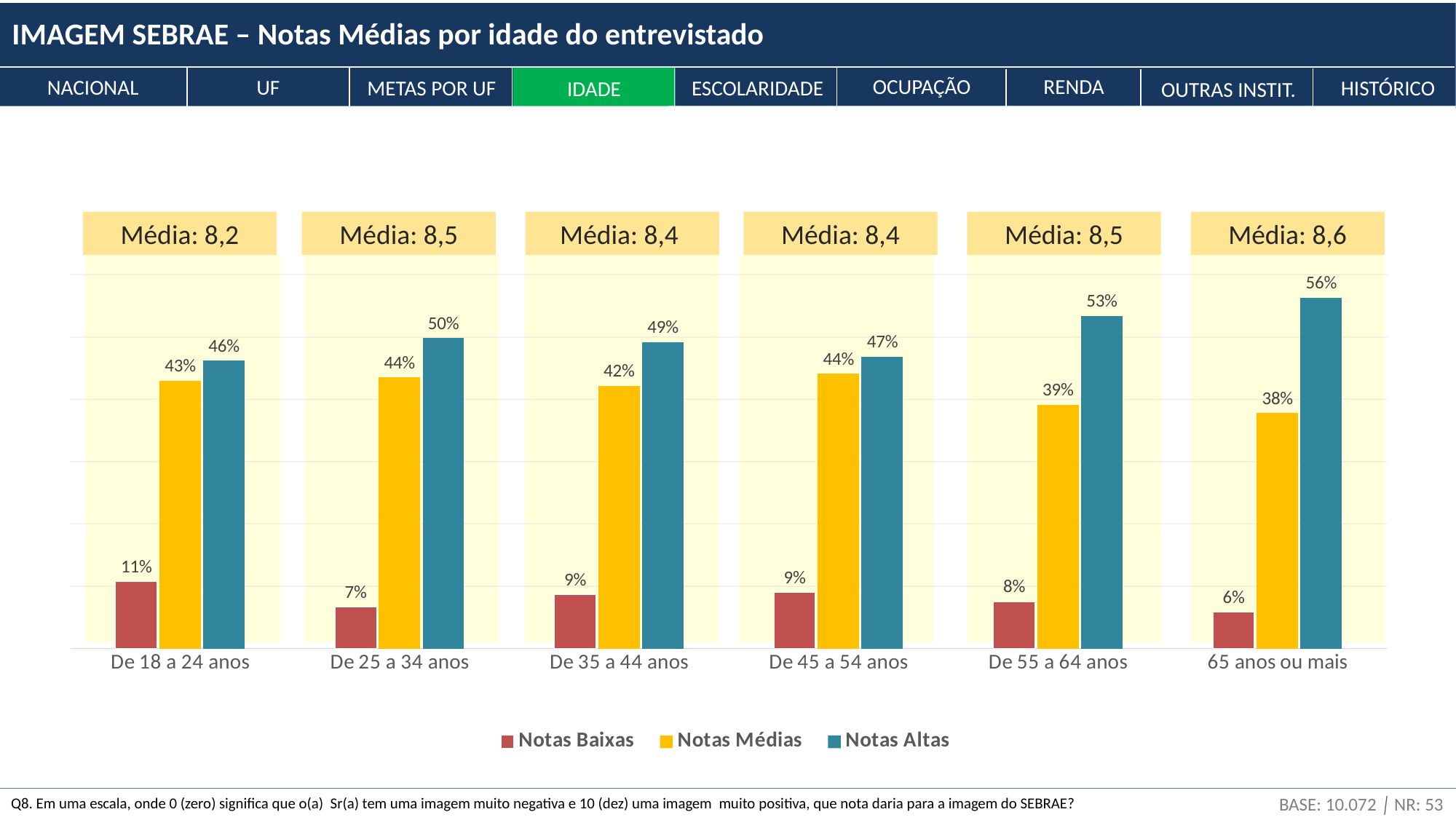
What is the value of Notas Médias for the '65 anos ou mais' age group? 38% How many series does the legend list? 3 What is the value of Notas Baixas for the 'De 18 a 24 anos' age group? 11% What is the 'Média' shown above the 'De 18 a 24 anos' age group? 8,2 Which is larger for the 'De 45 a 54 anos' age group: Notas Médias or Notas Altas? Notas Altas Which age group has the lowest value for Notas Baixas? 65 anos ou mais How many age groups are shown on the x axis? 6 Which age group has the highest value for Notas Altas? 65 anos ou mais What is the value of Notas Altas for the 'De 25 a 34 anos' age group? 50% Do the Notas Baixas values generally rise or fall from the youngest to the oldest age group? Fall What is the difference between Notas Altas and Notas Médias for the 'De 55 a 64 anos' age group? 14% What kind of chart is shown on the slide? Bar chart